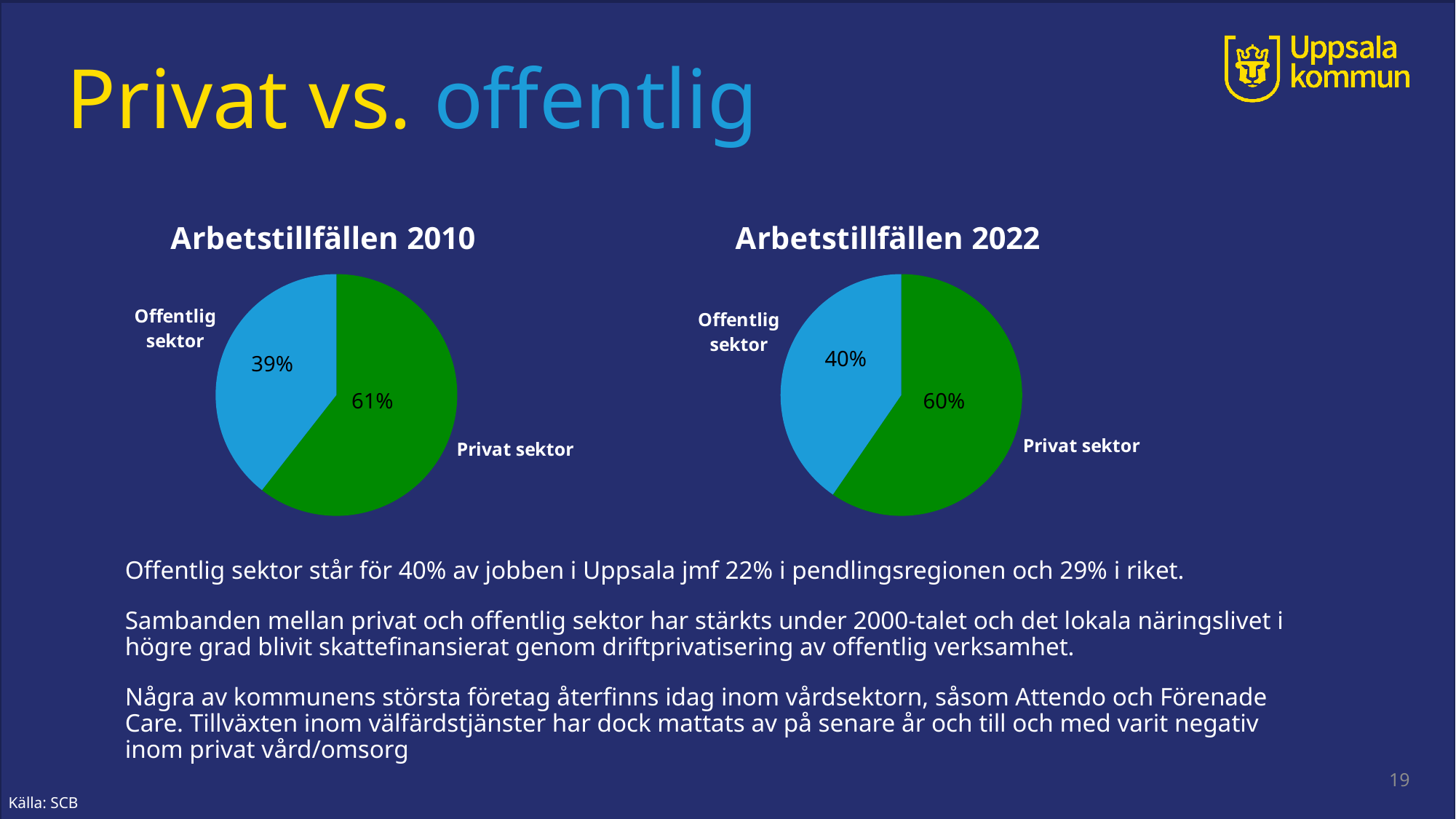
Is the Offentlig sektor share larger in the 'Arbetstillfällen 2010' chart or the 'Arbetstillfällen 2022' chart? Arbetstillfällen 2022 What kind of chart is 'Arbetstillfällen 2022'? Pie chart How many slices does the 'Arbetstillfällen 2010' pie chart have? 2 In the 'Arbetstillfällen 2010' chart, what is the difference in percentage points between Privat sektor and Offentlig sektor? 22 percentage points In the 'Arbetstillfällen 2010' chart, which sector has the largest slice? Privat sektor In the 'Arbetstillfällen 2010' chart, what share does Offentlig sektor have? 39% In the 'Arbetstillfällen 2022' chart, what is the difference in percentage points between Privat sektor and Offentlig sektor? 20 percentage points In the 'Arbetstillfällen 2022' chart, which sector has the smallest slice? Offentlig sektor In the 'Arbetstillfällen 2010' chart, what share does Privat sektor have? 61% In the 'Arbetstillfällen 2022' chart, what share does Privat sektor have? 60% In the 'Arbetstillfällen 2010' chart, what colour is the Privat sektor slice? Green In the 'Arbetstillfällen 2022' chart, what share does Offentlig sektor have? 40%